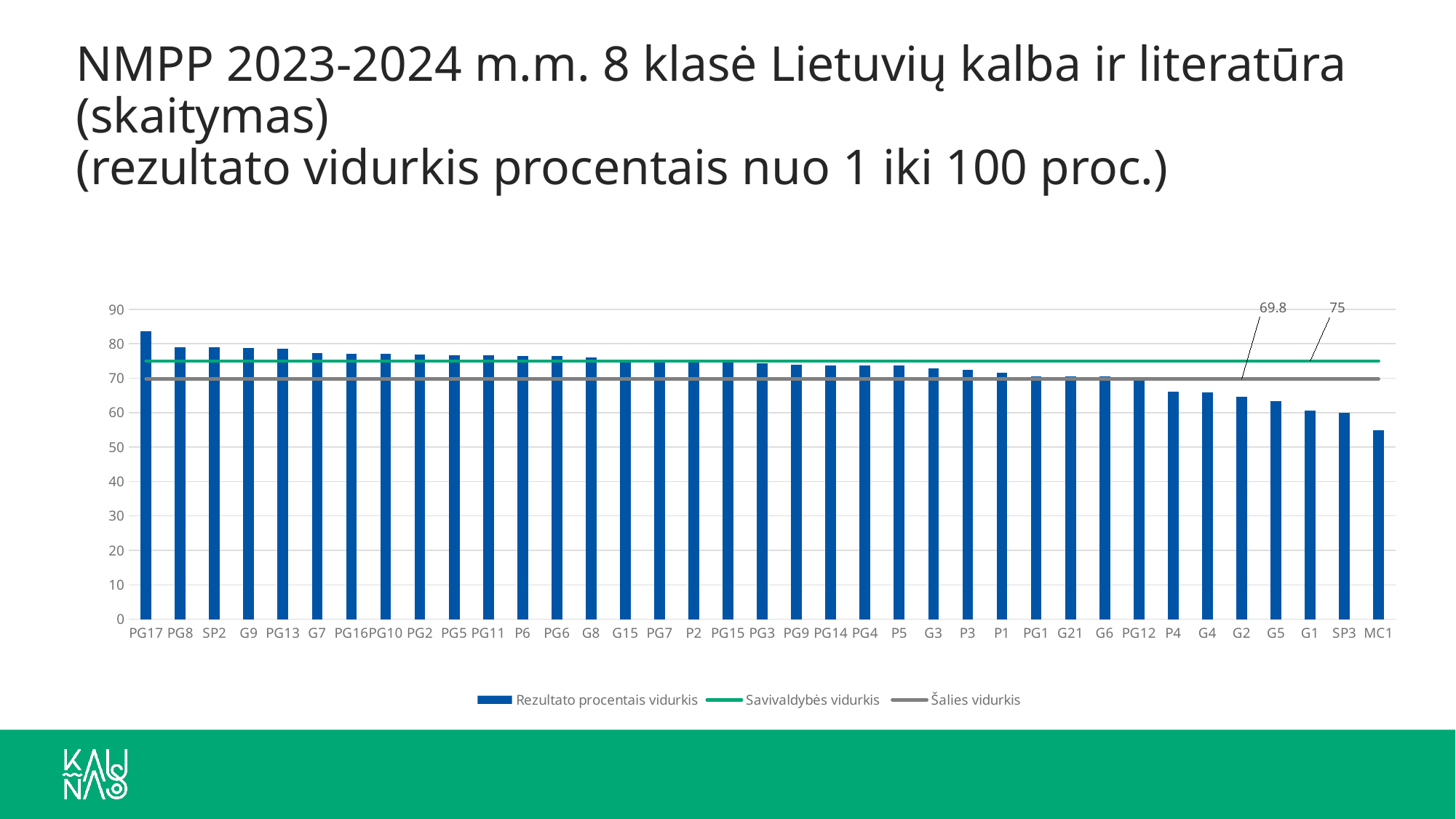
Do the bar values rise or fall from left to right along the x axis? fall Is the value for PG17 greater or less than 80? greater How many series does the legend list? 3 How many categories are shown on the x axis? 37 Is the value for MC1 greater or less than 60? less What is the value of the Savivaldybės vidurkis line? 75 Which category has the lowest value for Rezultato procentais vidurkis? MC1 Which category has the highest value for Rezultato procentais vidurkis? PG17 What type of chart is shown on the slide? combination bar and line chart What is the difference between the Savivaldybės vidurkis and the Šalies vidurkis? 5.2 What is the value of the Šalies vidurkis line? 69.8 Is the value for G2 greater or less than 70? less